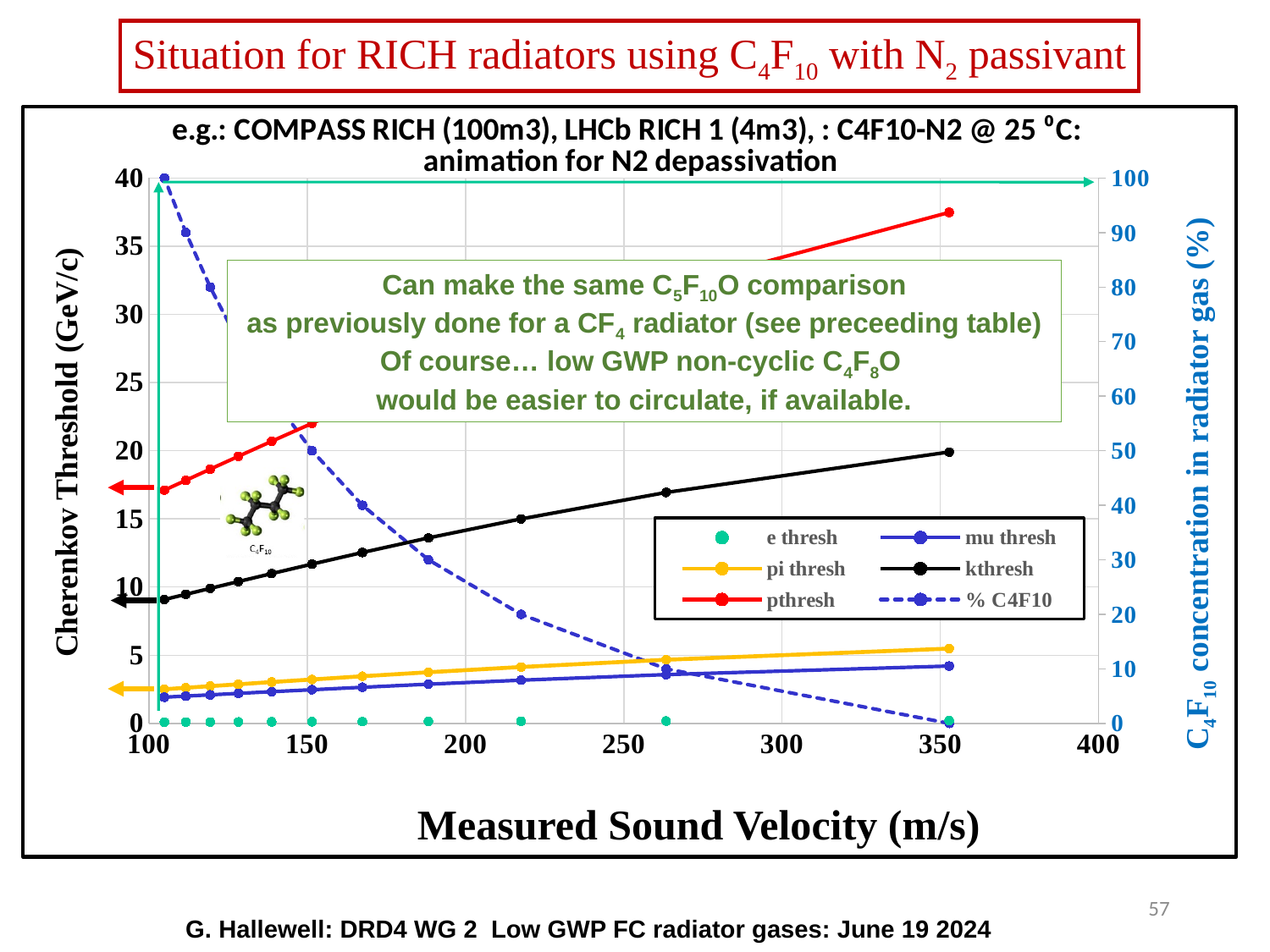
What kind of chart is shown on the slide? line chart What is the title of the x axis? Measured Sound Velocity (m/s) At around 350 m/s, which is larger: the pthresh value or the kthresh value? pthresh Which series has the lowest Cherenkov threshold across the chart? e thresh Which colour is used for the pthresh series in the legend? red Is the pthresh value at the right end of the chart (around 350 m/s) greater or less than 35 GeV/c? greater Which series has the highest Cherenkov threshold at the right end of the chart (around 350 m/s)? pthresh Is the % C4F10 value at around 350 m/s greater or less than 10%? less Does the % C4F10 series rise or fall as the measured sound velocity increases? fall Does the kthresh series rise or fall as the measured sound velocity increases? rise How many series does the chart legend list? 6 Is the kthresh value at the left end of the chart (around 105 m/s) greater or less than 10 GeV/c? less